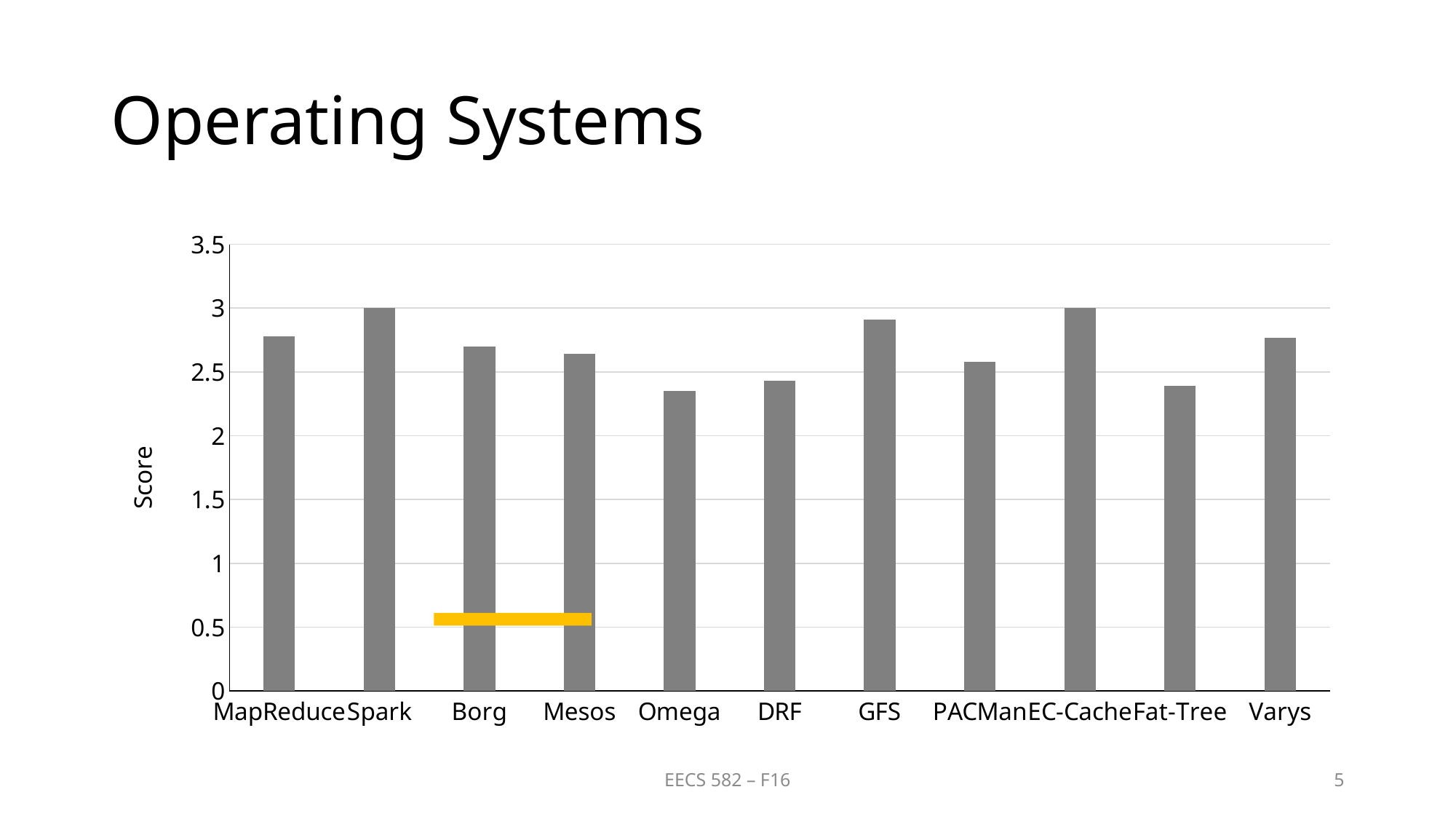
Is the score for Fat-Tree greater or less than 2.5? less Is the score for GFS greater or less than 2.5? greater Is the score for MapReduce greater or less than 2.5? greater What is the label on the vertical axis of the chart? Score What is the score for EC-Cache? 3 Which has the higher score, GFS or Omega? GFS Which has the higher score, Borg or DRF? Borg How many categories (systems) are plotted on the chart? 11 What kind of chart is shown on the slide? bar chart Which has the higher score, Spark or Fat-Tree? Spark What is the score for Spark? 3